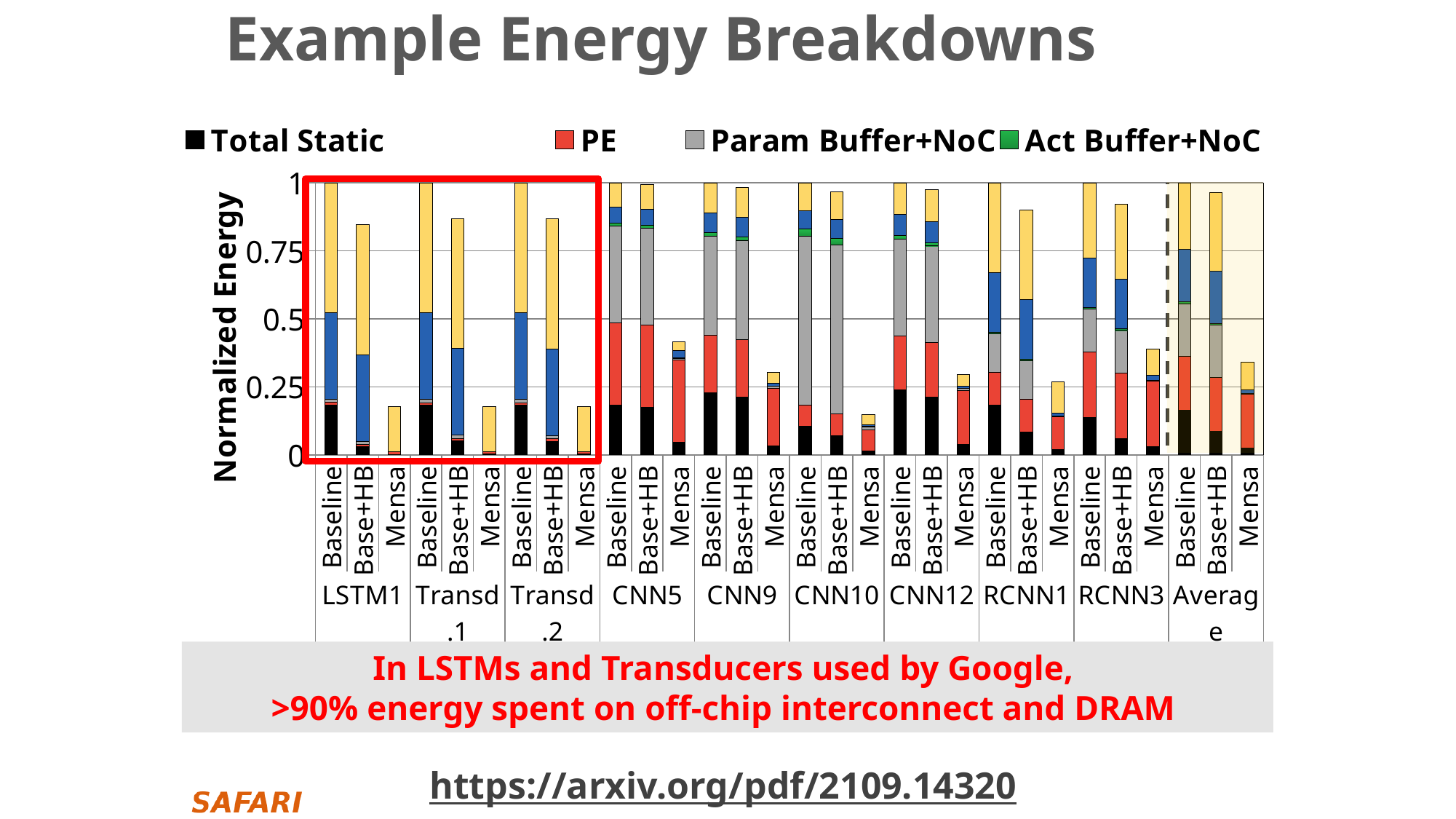
Which configuration has the lowest total normalized energy in the Average group? Mensa How many series does the legend list? 4 What kind of chart is shown on the slide? stacked bar chart Within the LSTM1 group, which bar is taller: Baseline or Mensa? Baseline Is the total normalized energy of the Mensa bar for Average greater or less than 0.25? greater What is the total normalized energy of the Baseline bar for LSTM1? 1 Is the total normalized energy of the Mensa bar for LSTM1 greater or less than 0.25? less Is the total normalized energy of the Base+HB bar for RCNN1 greater or less than 0.75? greater How many bars (configurations) are shown for each workload group? 3 How many workload groups are shown along the x axis of the chart? 10 What is the label of the y axis? Normalized Energy